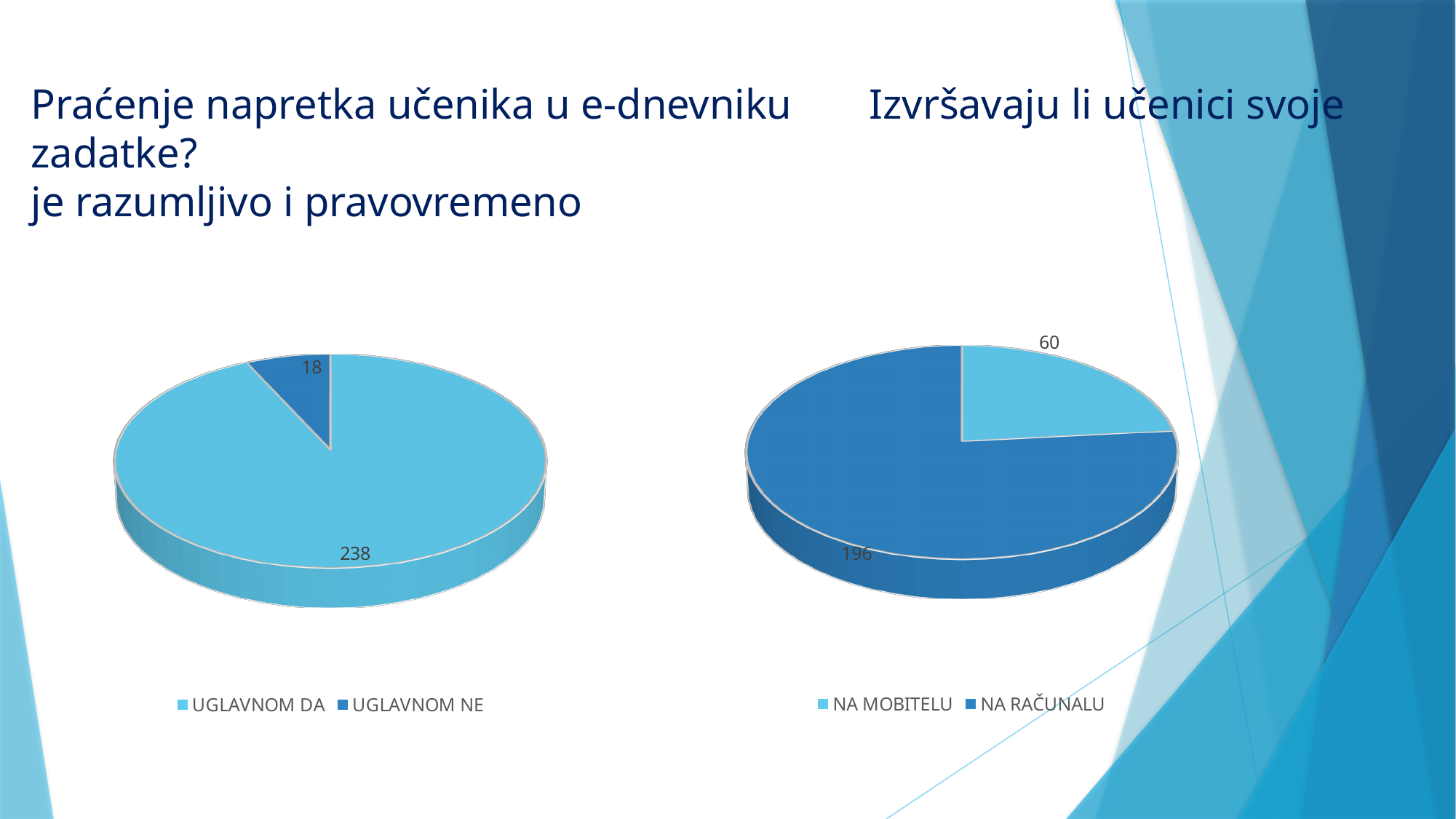
In the left pie chart, what is the value for UGLAVNOM DA? 238 In the right pie chart, what is the total of NA MOBITELU and NA RAČUNALU? 256 In the right pie chart, what is the difference between NA RAČUNALU and NA MOBITELU? 136 In the right pie chart, what is the value for NA RAČUNALU? 196 In the left pie chart, which category has the largest slice? UGLAVNOM DA How many categories does the left pie chart show? 2 In the right pie chart, which is larger, NA MOBITELU or NA RAČUNALU? NA RAČUNALU In the right pie chart, which category has the smallest slice? NA MOBITELU What type of chart is the right chart on the slide? Pie chart In the left pie chart, what is the difference between UGLAVNOM DA and UGLAVNOM NE? 220 In the right pie chart, what is the value for NA MOBITELU? 60 In the left pie chart, what is the value for UGLAVNOM NE? 18